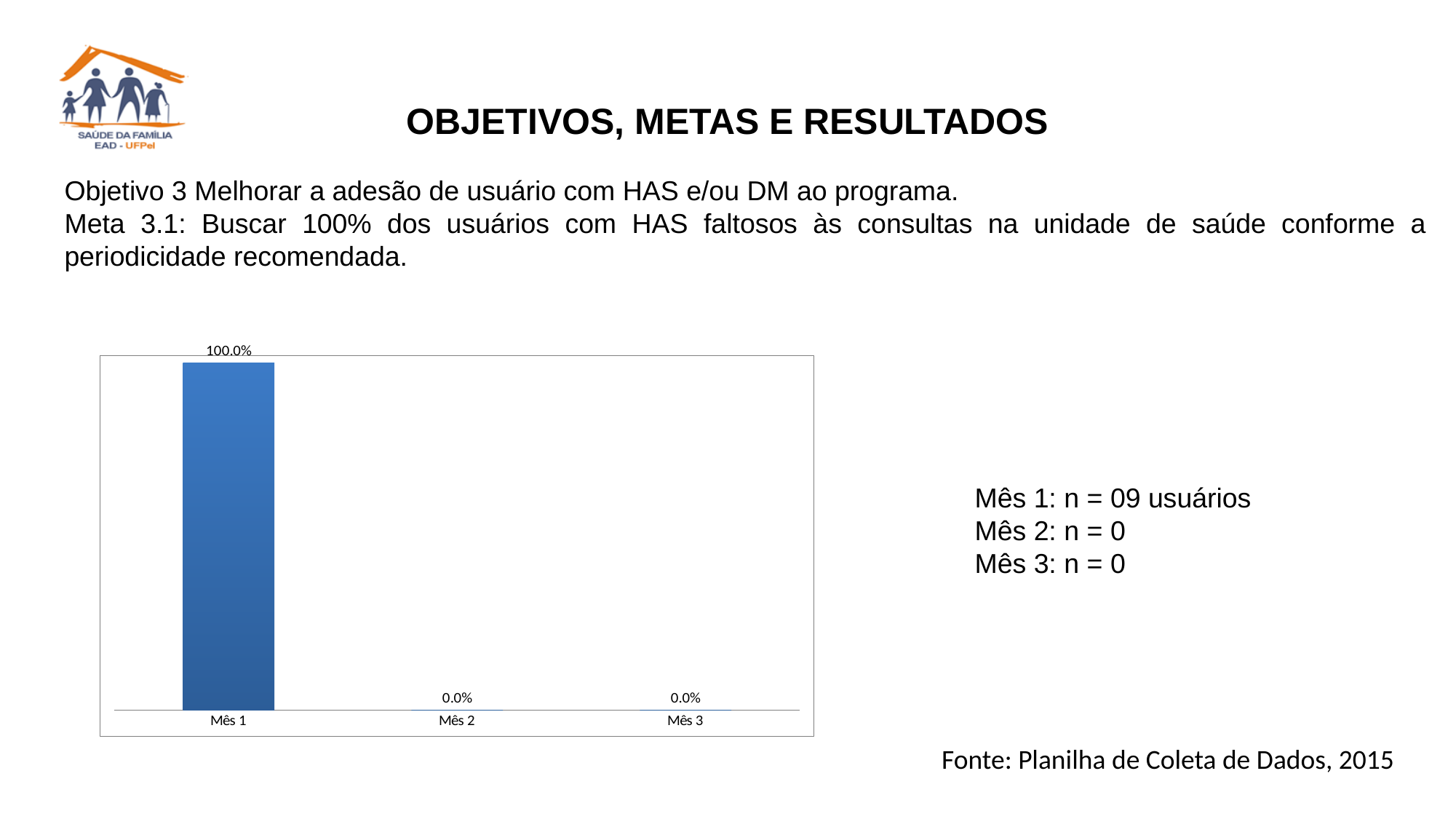
What is the source cited below the chart? Planilha de Coleta de Dados, 2015 Which is larger, the value for Mês 1 or the value for Mês 3? Mês 1 What is the value for Mês 1? 100.0% What kind of chart is shown on the slide? Bar chart What colour is the bar for Mês 1? Blue What is the difference between the values for Mês 1 and Mês 2? 100.0% What is the total of the values for Mês 1, Mês 2 and Mês 3? 100.0% How many categories are shown on the x axis? 3 What is the value for Mês 2? 0.0% Do the values rise or fall from Mês 1 to Mês 3? Fall What is the value for Mês 3? 0.0% Which category has the highest value? Mês 1